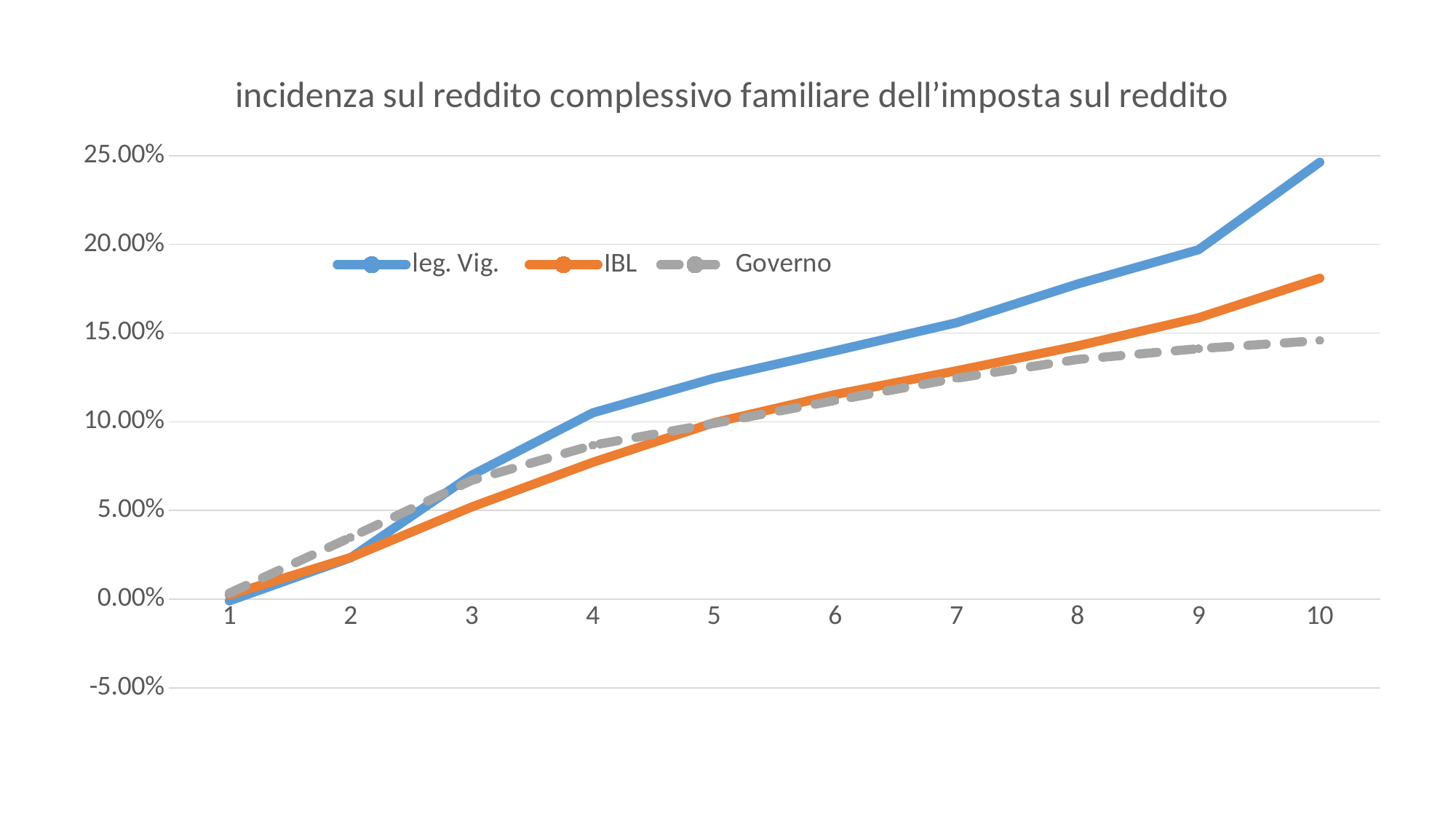
Which series has the highest value at 10? leg. Vig. Which series is drawn with a dashed line? Governo At 2, which is larger: the value for Governo or the value for leg. Vig.? Governo Which series has the lowest value at 10? Governo Is the value for IBL at 10 greater or less than 15.00%? greater How many points are plotted along the x axis for each series? 10 Is the value for leg. Vig. at 5 greater or less than 10.00%? greater Do the values of the leg. Vig. series rise or fall from 1 to 10 along the x axis? rise What kind of chart is shown on the slide? line chart How many series does the legend list? 3 Is the value for Governo at 10 greater or less than 15.00%? less